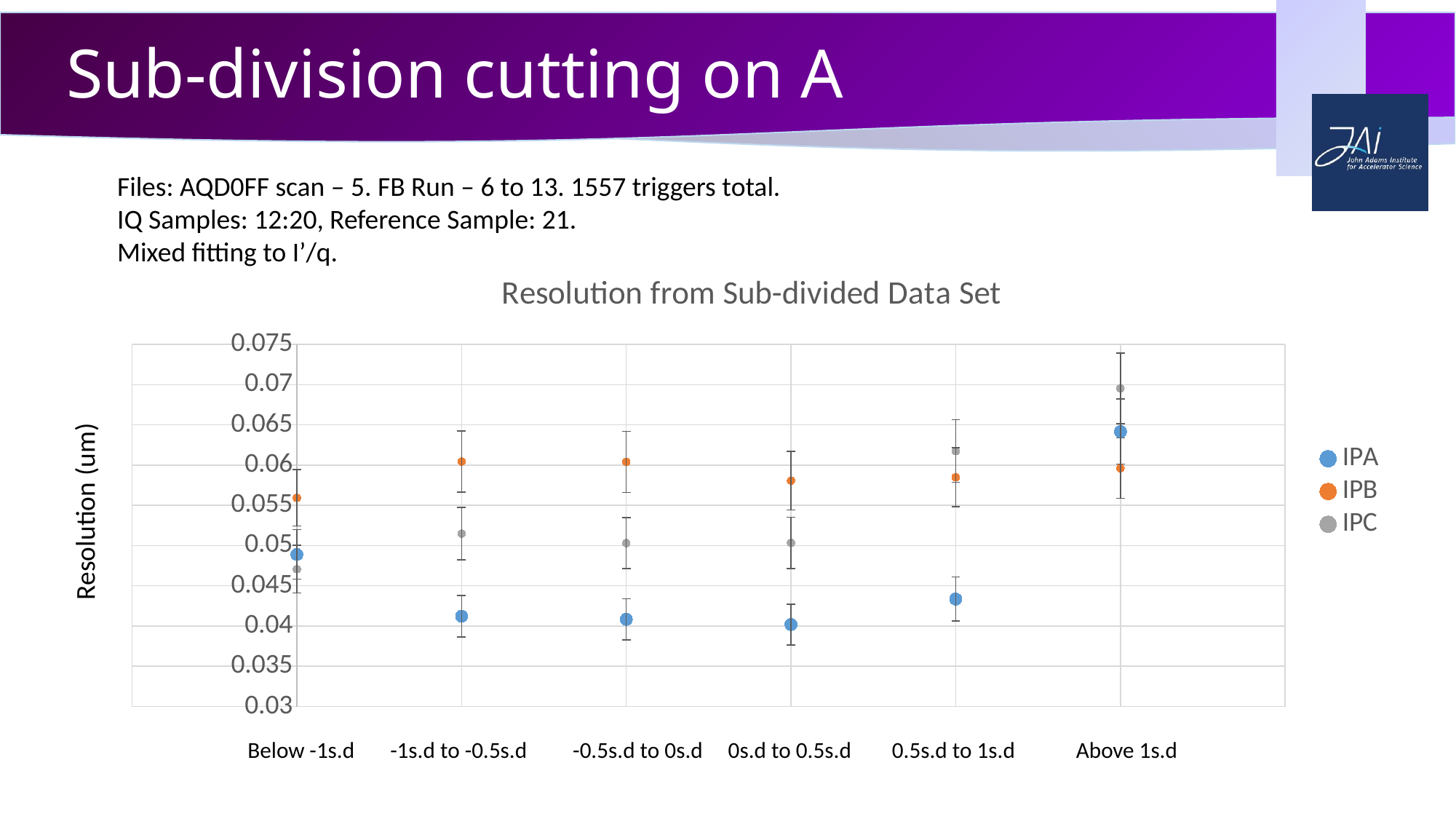
Is the IPB value for -1s.d to -0.5s.d greater or less than 0.055? greater Is the IPA value for 0s.d to 0.5s.d greater or less than 0.045? less Is the IPC value for Above 1s.d greater or less than 0.065? greater For the IPC series, which category has the highest resolution? Above 1s.d At Above 1s.d, which series has the larger value, IPB or IPC? IPC What kind of chart is shown on the slide? scatter chart How many categories are shown along the x axis? 6 At Below -1s.d, which series has the larger value, IPA or IPB? IPB For the IPA series, which category has the highest resolution? Above 1s.d How many series does the legend list? 3 For the IPC series, which category has the lowest resolution? Below -1s.d What is the title of the chart? Resolution from Sub-divided Data Set